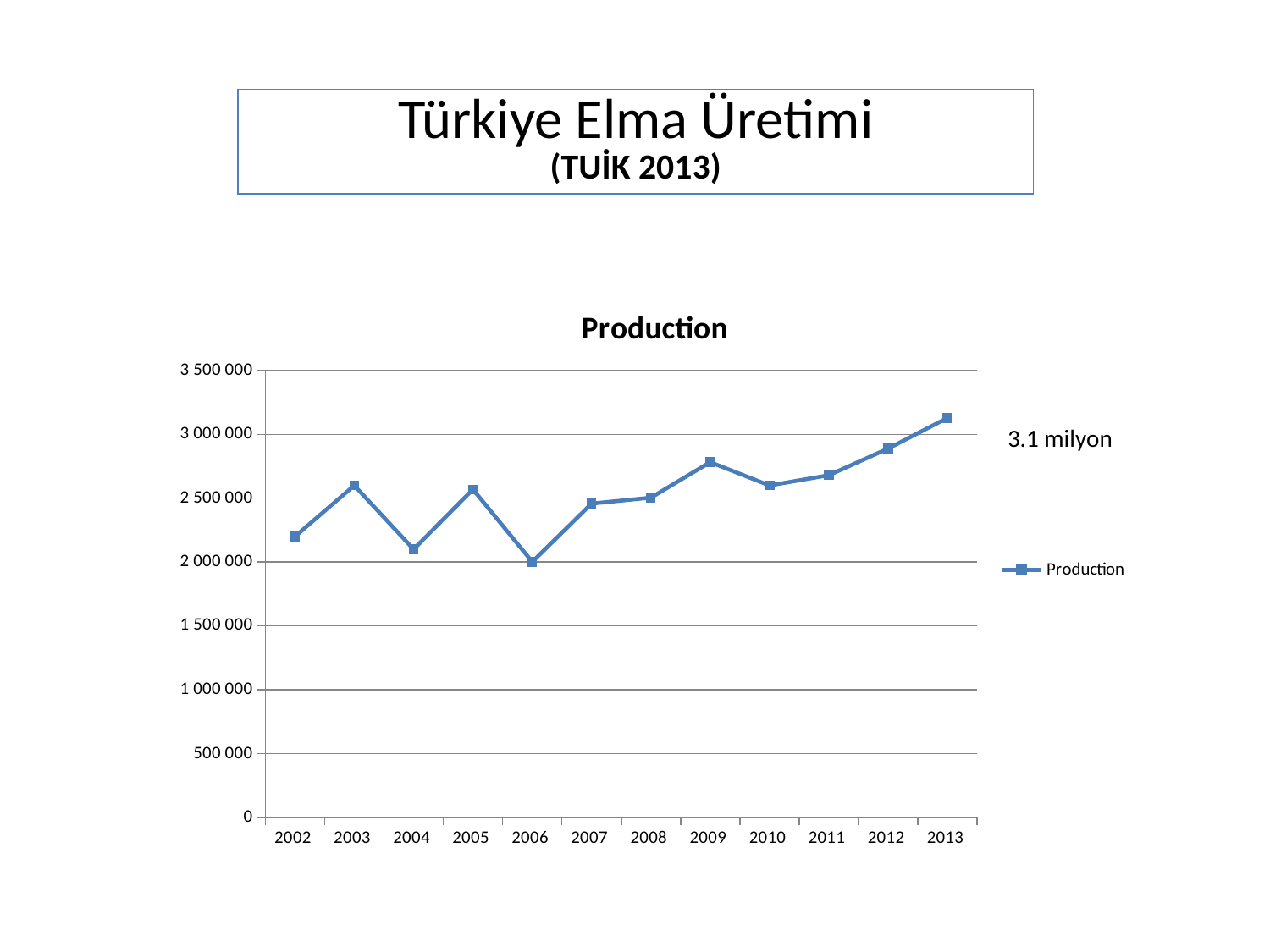
Is the production value for 2009 greater or less than 2 500 000? greater Which year has the larger production value, 2003 or 2004? 2003 Is the production value for 2013 greater or less than 3 000 000? greater How many years are plotted on the x axis of the Production chart? 12 How many series does the legend of the Production chart list? 1 Which year has the larger production value, 2009 or 2010? 2009 What kind of chart is shown on the slide? line chart Which year has the highest production value in the chart? 2013 Is the production value for 2004 greater or less than 2 500 000? less Which year has the lowest production value in the chart? 2006 What is the title of the chart on the slide? Production